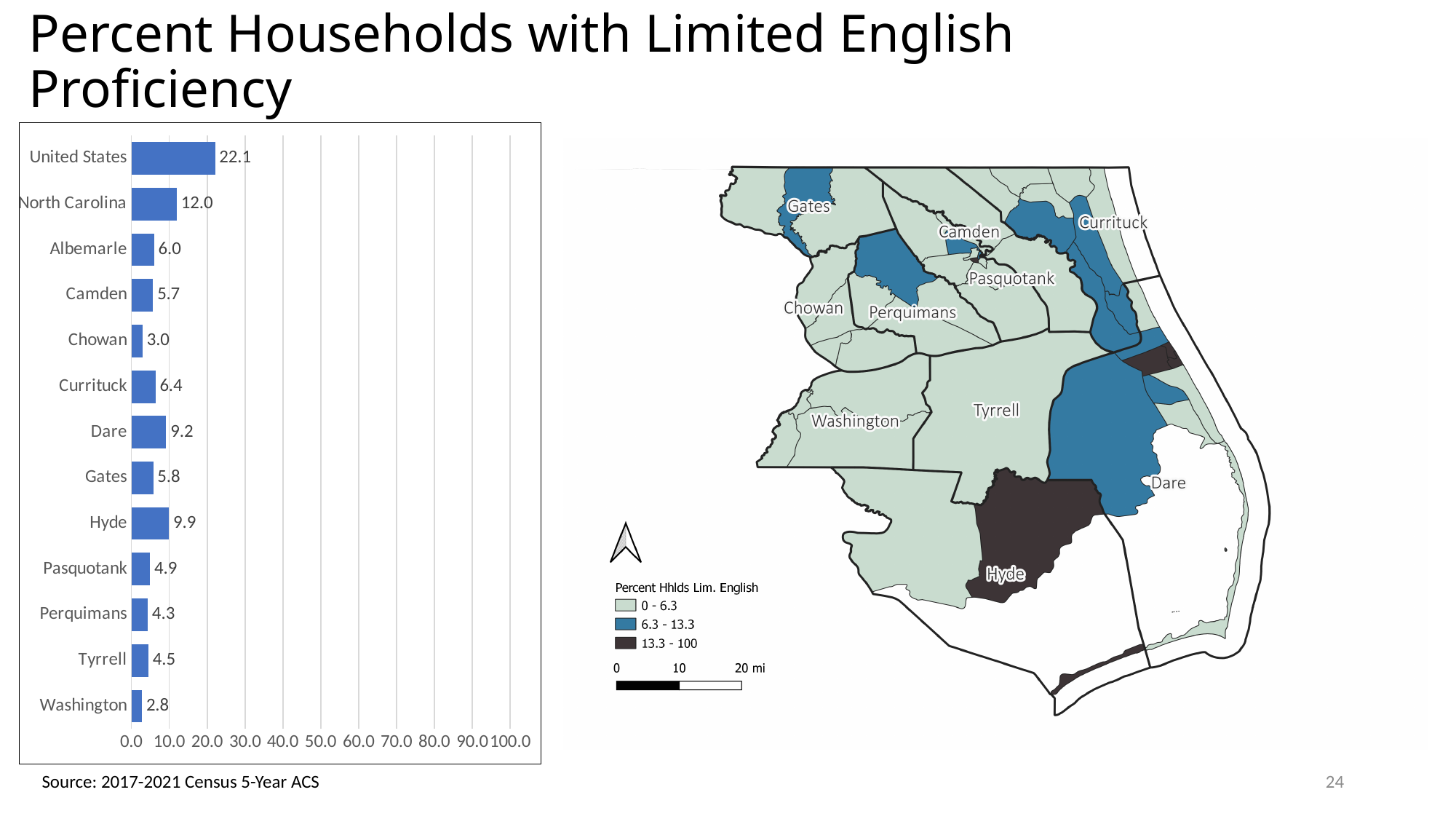
What is the value for Washington in the bar chart? 2.8 What is the difference between the values for the United States and North Carolina in the bar chart? 10.1 Which category has the highest value in the bar chart? United States Is the value for North Carolina in the bar chart greater or less than 10.0? greater What is the difference between the values for Hyde and Chowan in the bar chart? 6.9 What is the value for the United States in the bar chart? 22.1 What is the value for Hyde in the bar chart? 9.9 What kind of chart is on the left side of the slide? bar chart What is the maximum value shown on the x axis of the bar chart? 100.0 How many categories are shown in the bar chart? 13 Which has a larger value in the bar chart, Dare or Currituck? Dare Which category has the lowest value in the bar chart? Washington